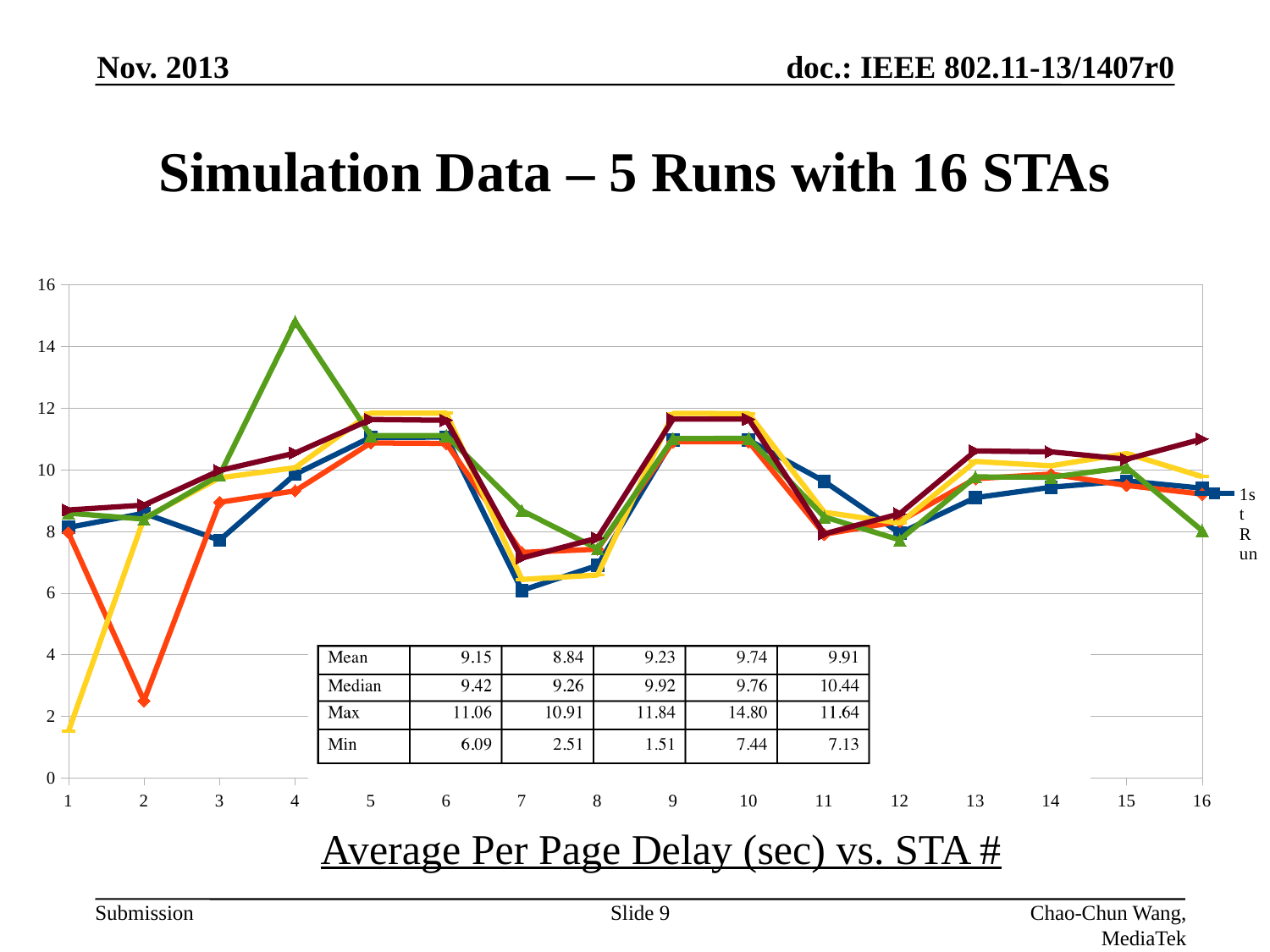
At which STA # does the highest point on the chart occur? 4 At which STA # does the lowest point on the chart occur? 1 Is the lowest value at STA 2 greater or less than 4? less How many STA categories are shown along the x axis? 16 What caption is written below the chart describing the axes? Average Per Page Delay (sec) vs. STA # What is the title of the slide containing the chart? Simulation Data – 5 Runs with 16 STAs How many lines (runs) are plotted on the chart? 5 In the table on the chart, what is the largest value in the Max row? 14.80 Is the lowest value at STA 7 greater or less than 8? less What kind of chart is shown on the slide? line chart Is the highest value at STA 4 greater or less than 14? greater